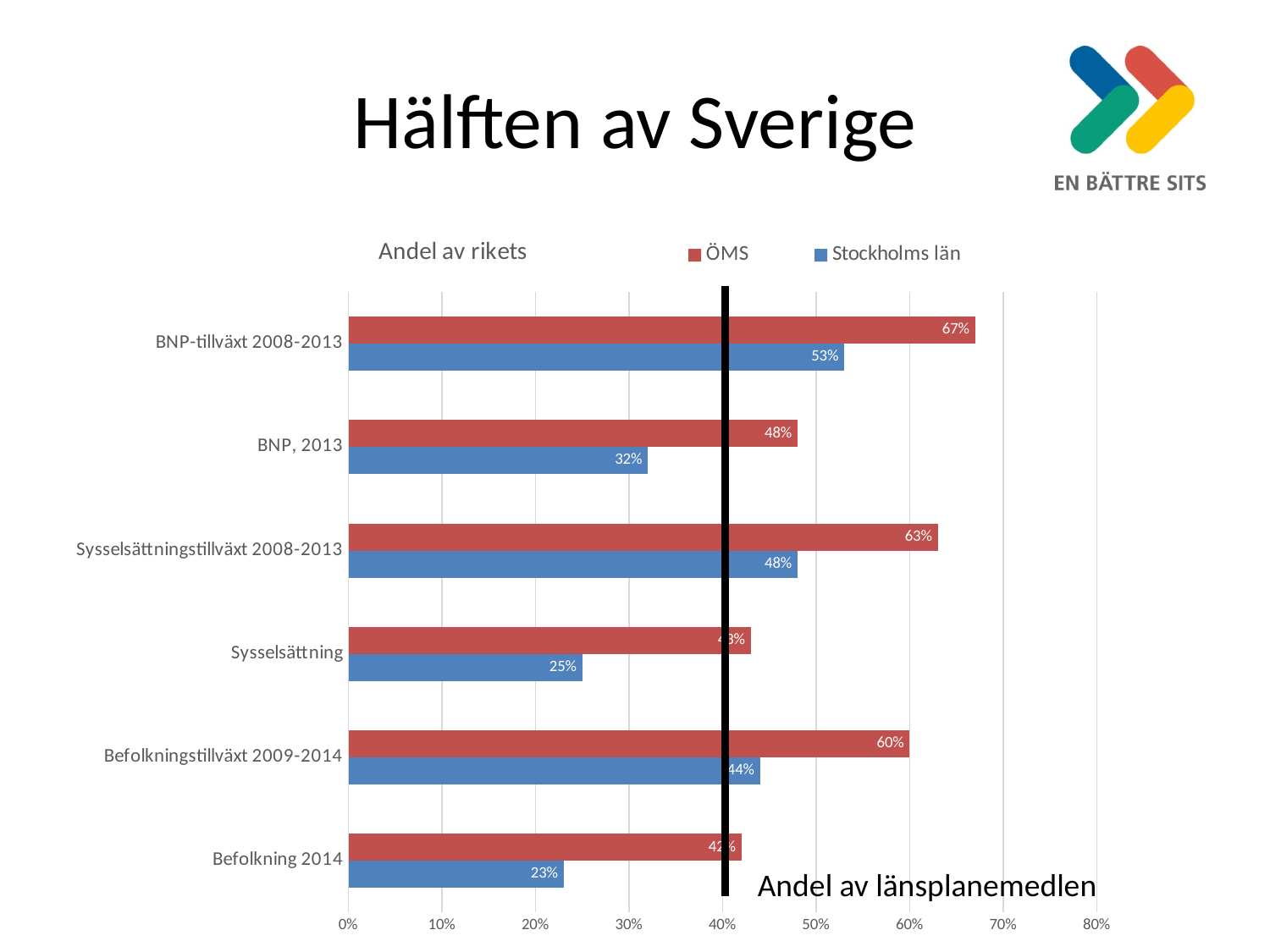
What is the difference between the ÖMS and Stockholms län values for Sysselsättningstillväxt 2008-2013? 15% What kind of chart is shown on the slide? bar chart Which category has the lowest Stockholms län value? Befolkning 2014 How many series does the legend list? 2 What is the title of the chart? Andel av rikets What is the ÖMS value for Befolkningstillväxt 2009-2014? 60% Is the Stockholms län value for Sysselsättning greater or less than 30%? less What is the Stockholms län value for BNP, 2013? 32% What is the Stockholms län value for Befolkning 2014? 23% How many categories are shown on the chart? 6 Which category has the highest ÖMS value? BNP-tillväxt 2008-2013 What is the ÖMS value for BNP-tillväxt 2008-2013? 67%